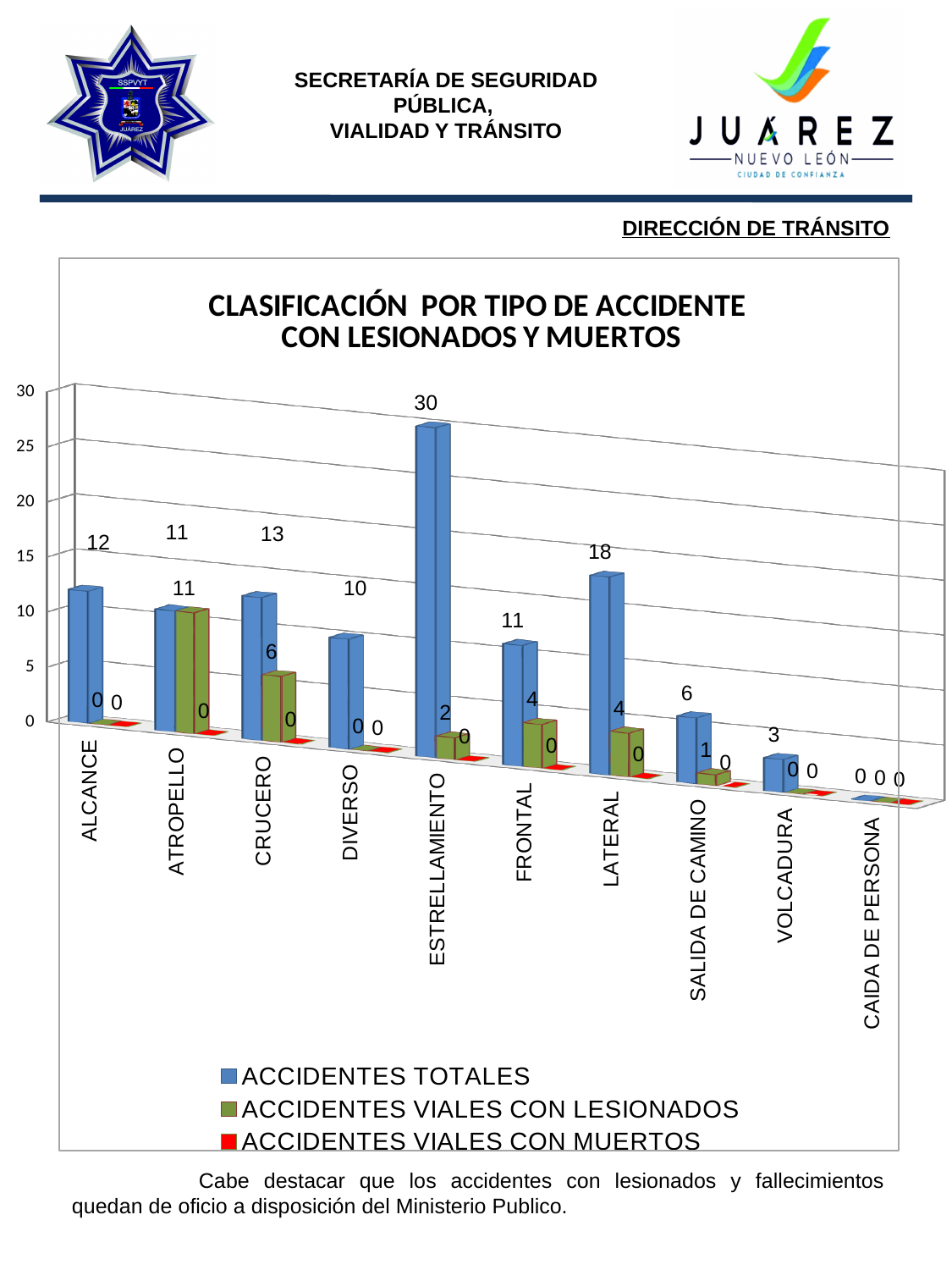
Which is larger: ACCIDENTES TOTALES for CRUCERO or for ALCANCE? CRUCERO Which series is shown in red in the legend? ACCIDENTES VIALES CON MUERTOS What is the difference between ACCIDENTES TOTALES for ESTRELLAMIENTO and for LATERAL? 12 What is the value of ACCIDENTES VIALES CON LESIONADOS for ATROPELLO? 11 Which category has the lowest value of ACCIDENTES TOTALES? CAIDA DE PERSONA What is the value of ACCIDENTES VIALES CON LESIONADOS for CRUCERO? 6 Which category has the highest value of ACCIDENTES TOTALES? ESTRELLAMIENTO What is the value of ACCIDENTES TOTALES for ESTRELLAMIENTO? 30 What kind of chart is shown on the slide? Bar chart How many accident categories are shown on the x axis? 10 How many series does the legend list? 3 What is the value of ACCIDENTES TOTALES for LATERAL? 18